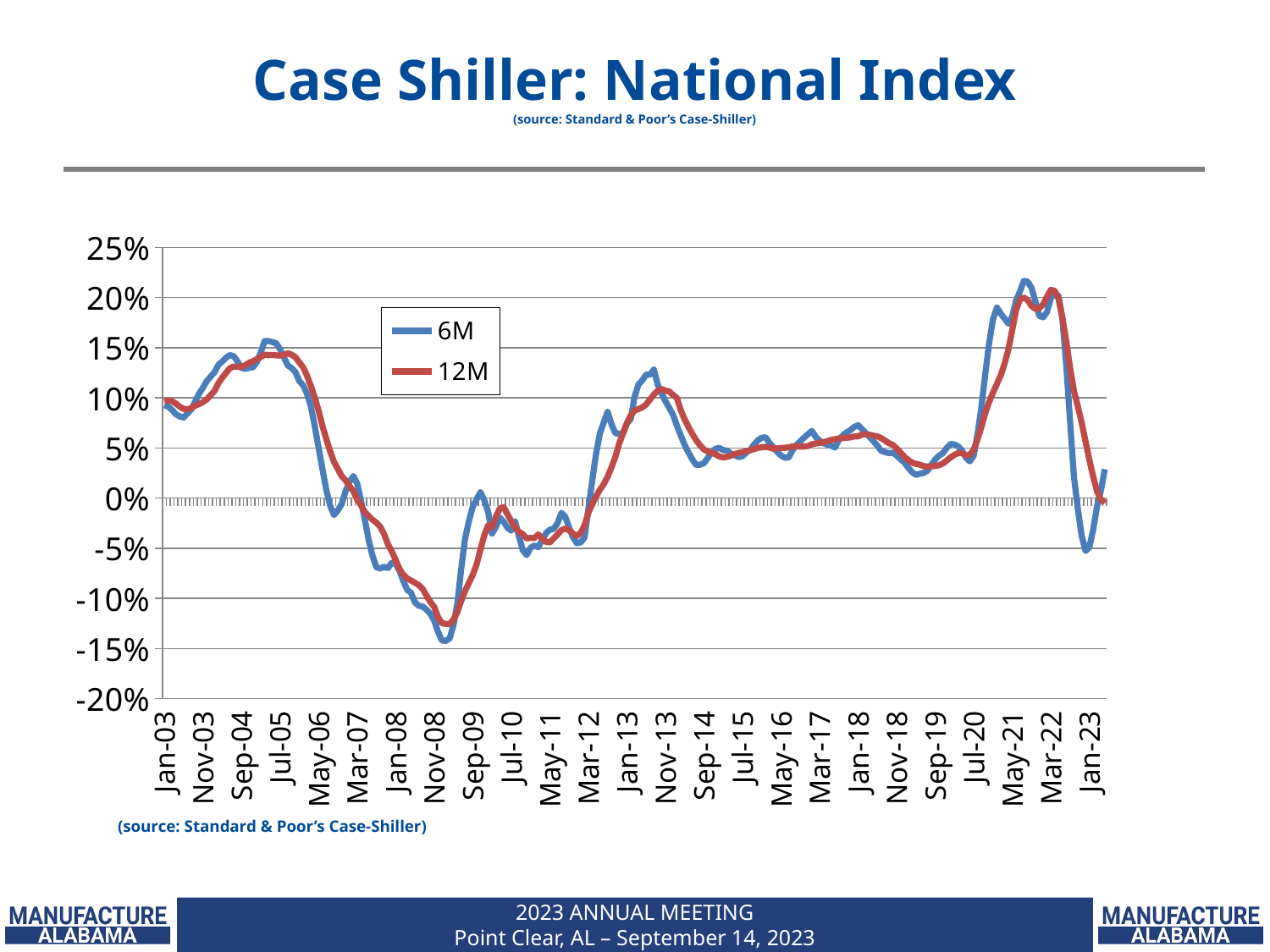
Is the value of the 12M series at Jan-13 greater or less than 5%? greater What colour is the 12M line? Red What are the two series named in the legend? 6M and 12M What kind of chart is shown on the slide? Line chart Is the value of the 12M series at Jul-15 greater or less than 10%? less Does the 12M series rise or fall between Jul-05 and Nov-08? Fall Is the peak value of the 6M series around May-21 greater or less than 20%? greater Does the 12M series rise or fall between Mar-22 and Jan-23? Fall How many series does the legend list? 2 Does the 12M series rise or fall between Nov-08 and Jan-13? Rise